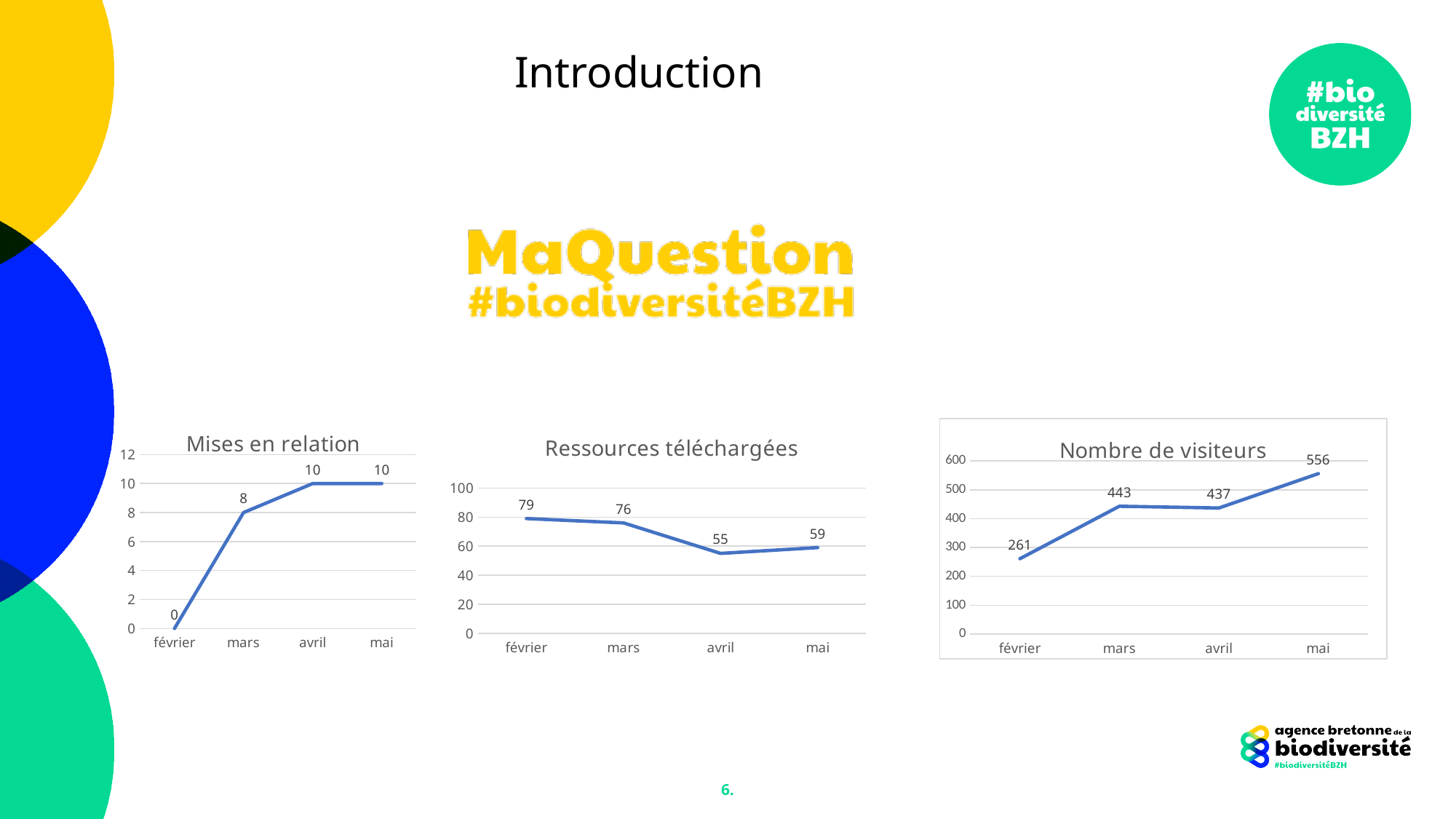
In the 'Nombre de visiteurs' chart, what is the value for mai? 556 In the 'Ressources téléchargées' chart, which month has the highest value? février In the 'Nombre de visiteurs' chart, which month has the lowest value? février In the 'Nombre de visiteurs' chart, is the value for mars greater or less than 400? greater In the 'Mises en relation' chart, what is the value for février? 0 What kind of chart is 'Mises en relation'? line chart In the 'Nombre de visiteurs' chart, do the values generally rise or fall from février to mai? rise In the 'Nombre de visiteurs' chart, what is the difference between mars and avril? 6 In the 'Ressources téléchargées' chart, what is the value for avril? 55 How many months are plotted in the 'Ressources téléchargées' chart? 4 In the 'Ressources téléchargées' chart, what is the difference between février and mai? 20 In the 'Mises en relation' chart, what is the value for mars? 8